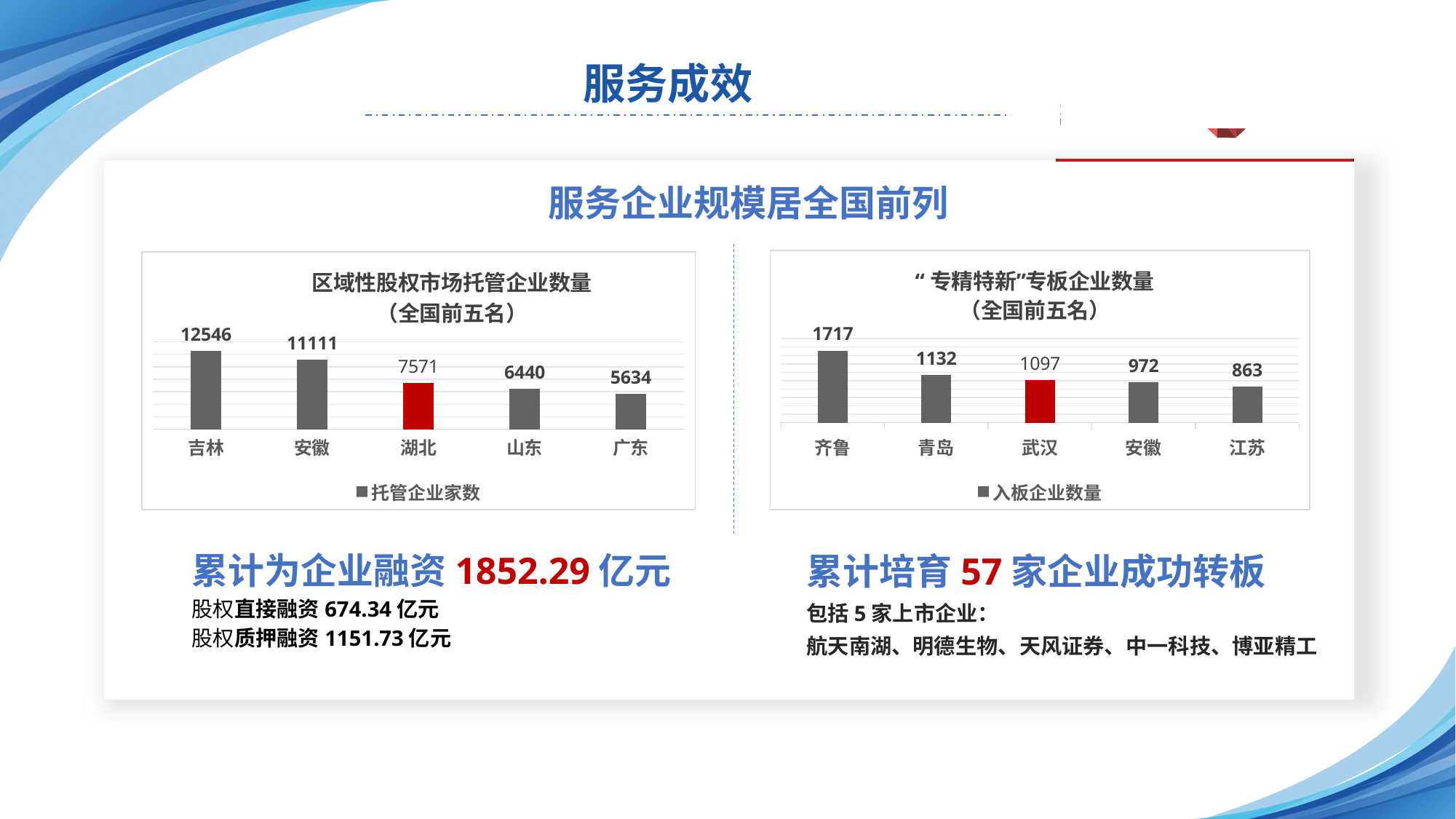
In the left chart (区域性股权市场托管企业数量), which category has the highest value? 吉林 In the left chart (区域性股权市场托管企业数量), what is the legend entry? 托管企业家数 In the left chart (区域性股权市场托管企业数量), which category has the lowest value? 广东 In the left chart (区域性股权市场托管企业数量), what is the difference between the values for 吉林 and 安徽? 1435 What type of chart is the right chart (“专精特新”专板企业数量)? Bar chart In the right chart (“专精特新”专板企业数量), which category has the lowest value? 江苏 In the left chart (区域性股权市场托管企业数量), how many categories are shown? 5 In the right chart (“专精特新”专板企业数量), what is the value for 武汉? 1097 In the right chart (“专精特新”专板企业数量), which is larger, the value for 青岛 or the value for 武汉? 青岛 In the left chart (区域性股权市场托管企业数量), what is the value for 湖北? 7571 In the right chart (“专精特新”专板企业数量), which category has the highest value? 齐鲁 In the right chart (“专精特新”专板企业数量), what is the difference between the values for 青岛 and 安徽? 160